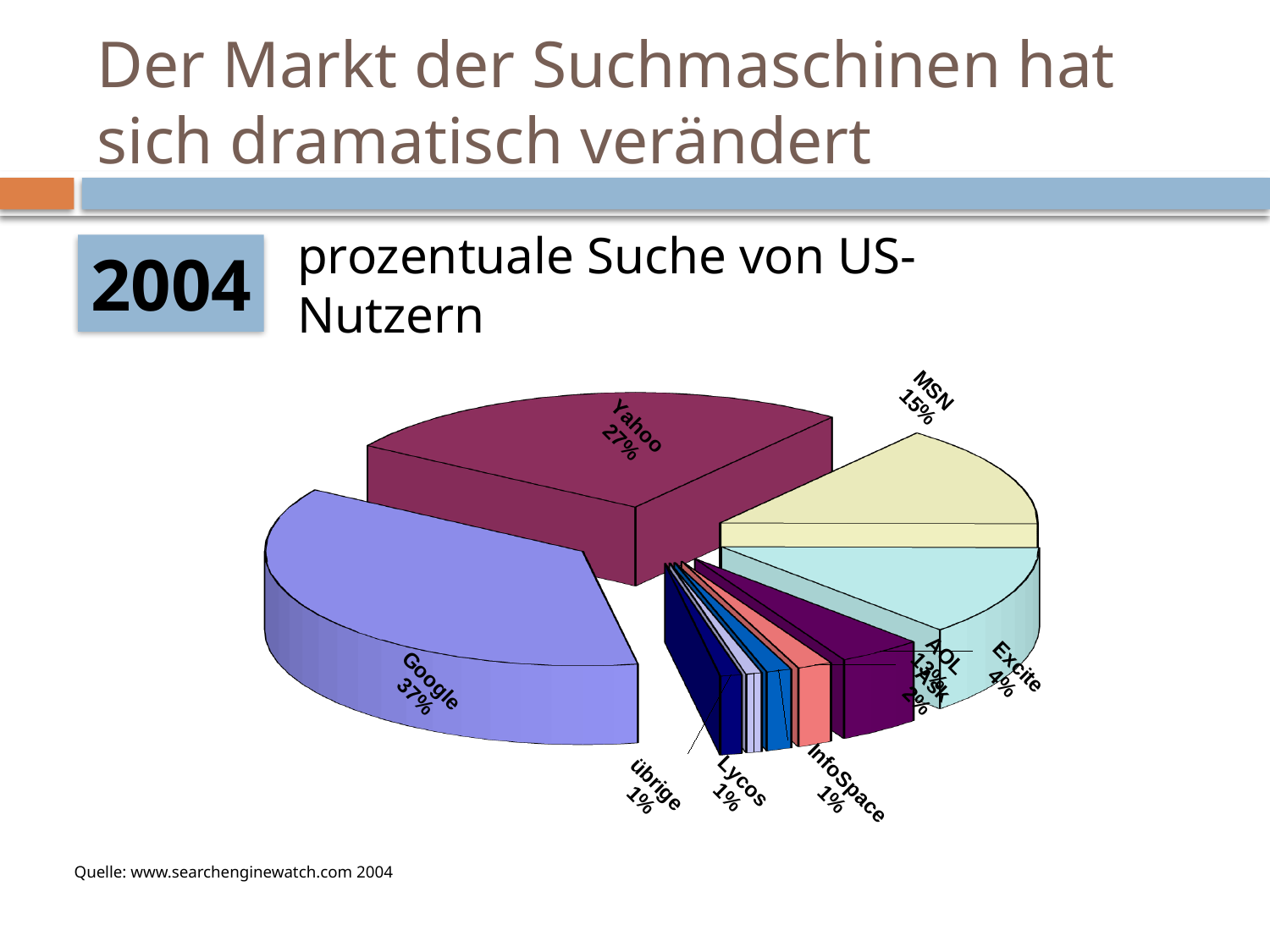
What percentage is shown for Yahoo? 27% What share of the pie does Google have? 37% What percentage is shown for Lycos? 1% By how many percentage points does Google's share exceed Yahoo's? 10 What kind of chart is shown on the slide? Pie chart Which year does the chart refer to? 2004 What percentage is shown for MSN? 15% What is the source cited for the chart? www.searchenginewatch.com 2004 Which search engine has the largest slice of the pie? Google Which has a larger share, Yahoo or MSN? Yahoo What share of the pie does InfoSpace hold? 1% What percentage is shown for Excite? 4%